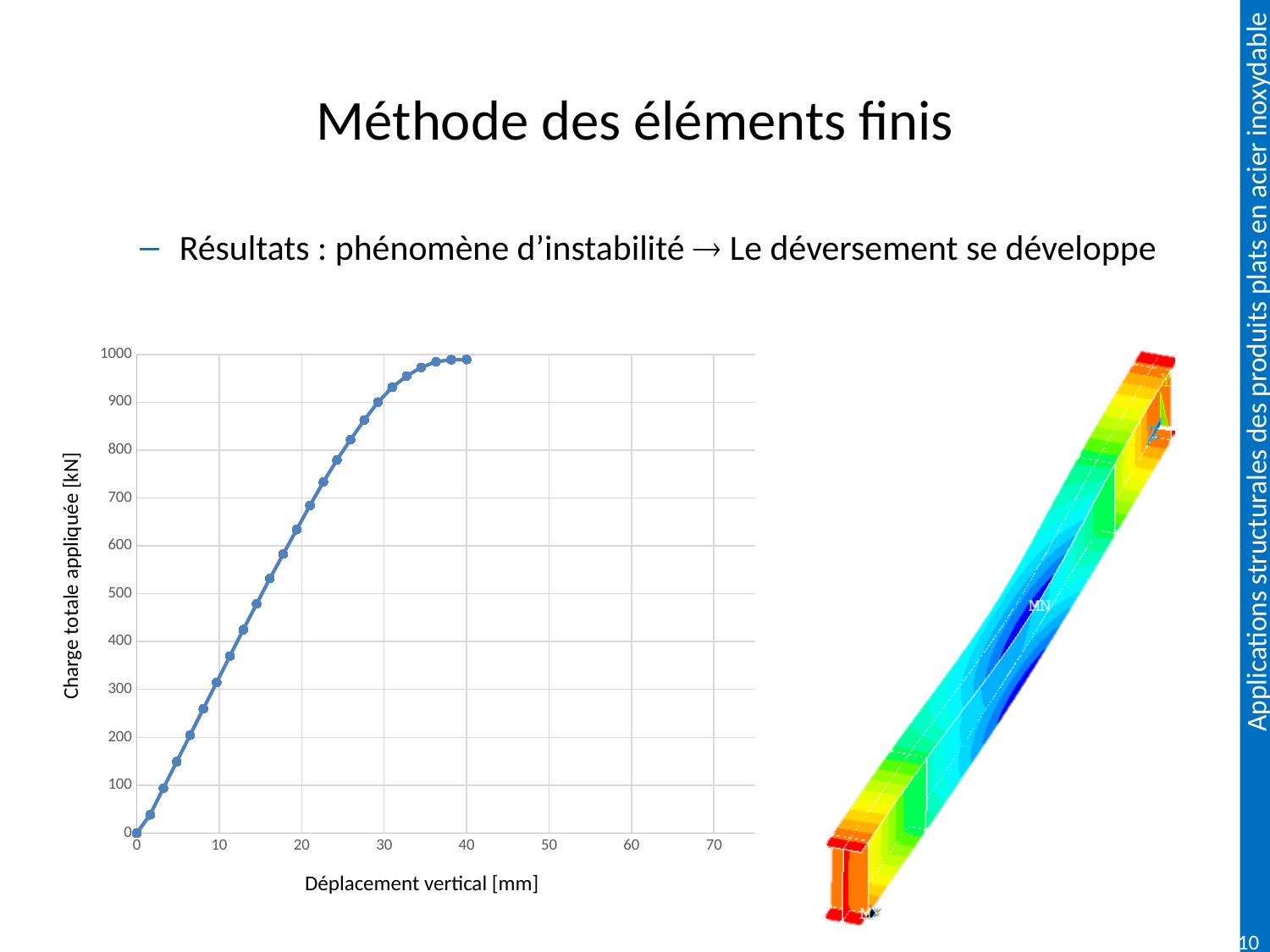
Is the highest applied load reached by the curve greater or less than 900 kN? greater What is the label of the x axis of the chart? Déplacement vertical [mm] Is the applied load at a vertical displacement of 20 mm greater or less than 600 kN? greater Is the applied load at a vertical displacement of 10 mm greater or less than 400 kN? less What kind of chart is shown on the slide? line chart What is the label of the y axis of the chart? Charge totale appliquée [kN] Does the applied load rise or fall as the vertical displacement increases along the x axis? rise What is the applied load at a vertical displacement of 0 mm? 0